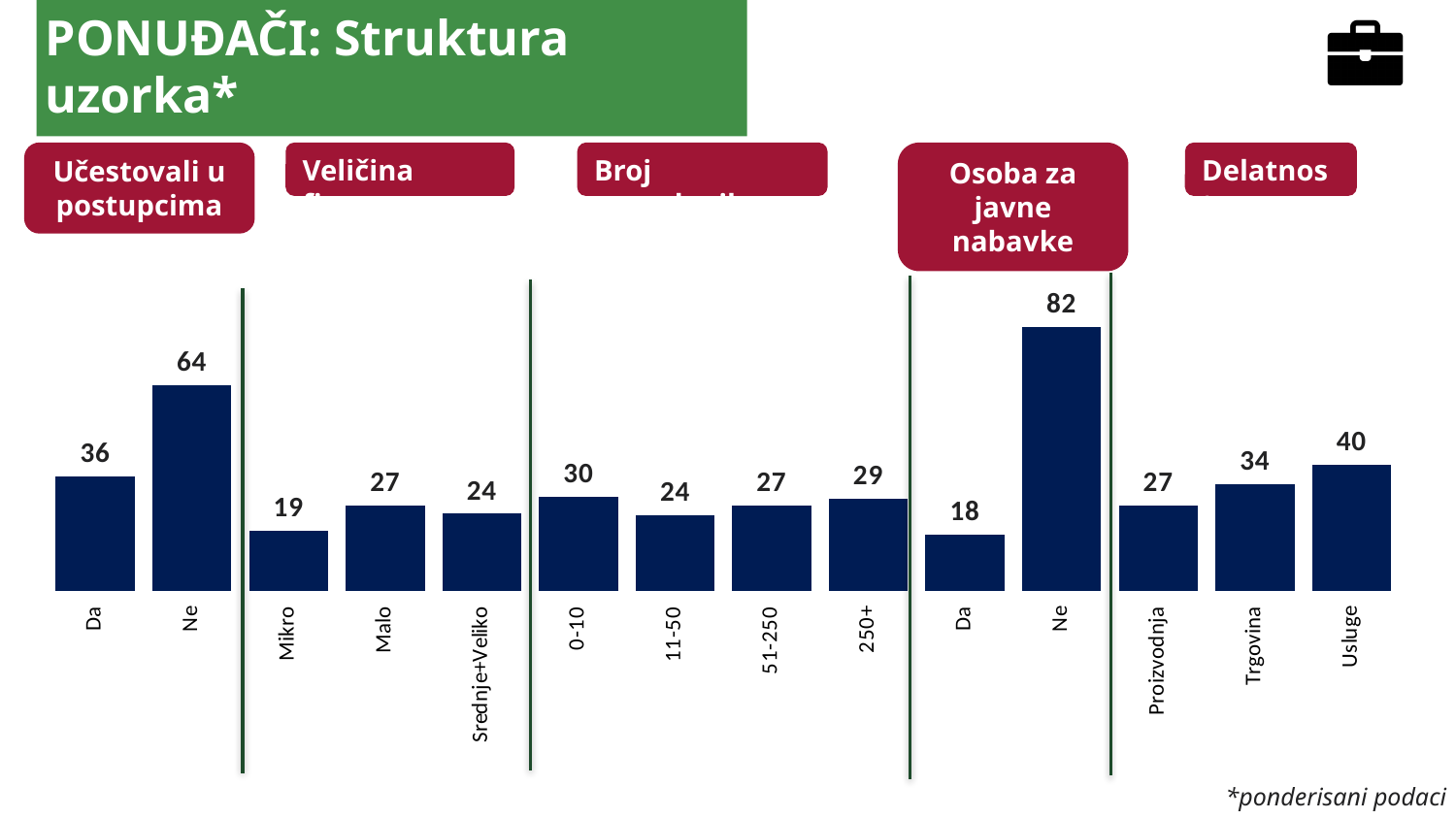
Which bar has the highest value on the chart? Ne (Osoba za javne nabavke), 82 What is the value for Mikro? 19 What is the title of the slide? PONUĐAČI: Struktura uzorka* What is the value for the 250+ category? 29 Which is larger, 0-10 or 11-50? 0-10 Which bar has the lowest value on the chart? Da (Osoba za javne nabavke), 18 What is the value for Usluge? 40 What kind of chart is shown on the slide? Bar chart In the 'Osoba za javne nabavke' group, what is the value for Ne? 82 Which is larger, Trgovina or Proizvodnja? Trgovina In the 'Učestovali u postupcima' group, what is the difference between Ne and Da? 28 How many bars are plotted on the chart? 14